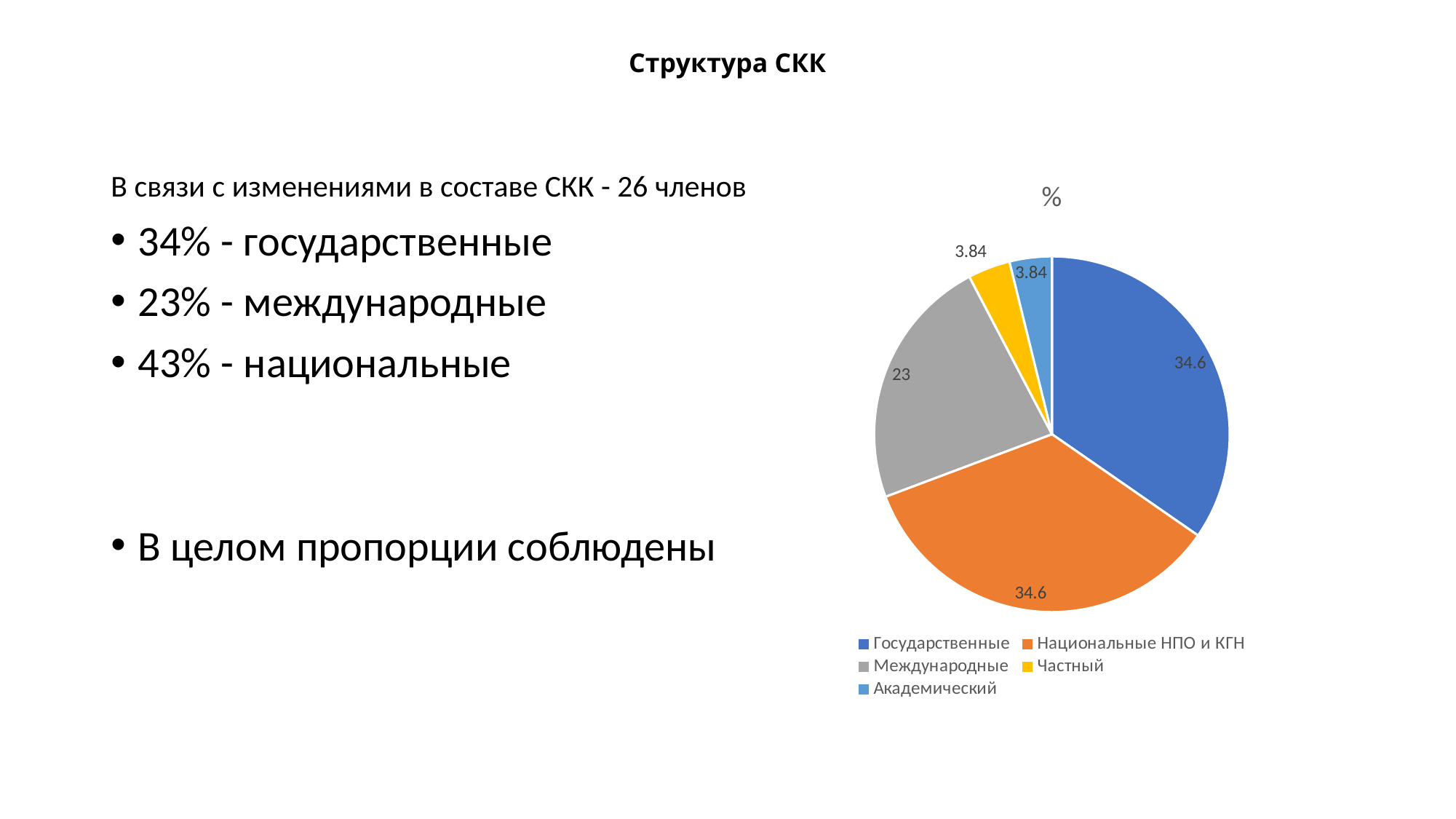
What value is shown for the Международные slice of the pie chart? 23 What value is shown for the Национальные НПО и КГН slice of the pie chart? 34.6 What is the title of the chart on the slide? % Which slice is larger in the pie chart: Международные or Частный? Международные What kind of chart is shown on the slide? Pie chart Which slice is larger in the pie chart: Государственные or Международные? Государственные What value is shown for the Государственные slice of the pie chart? 34.6 How many entries does the legend of the pie chart list? 5 What value is shown for the Академический slice of the pie chart? 3.84 What is the difference between the Государственные and Международные values in the pie chart? 11.6 What value is shown for the Частный slice of the pie chart? 3.84 How many slices does the pie chart have? 5